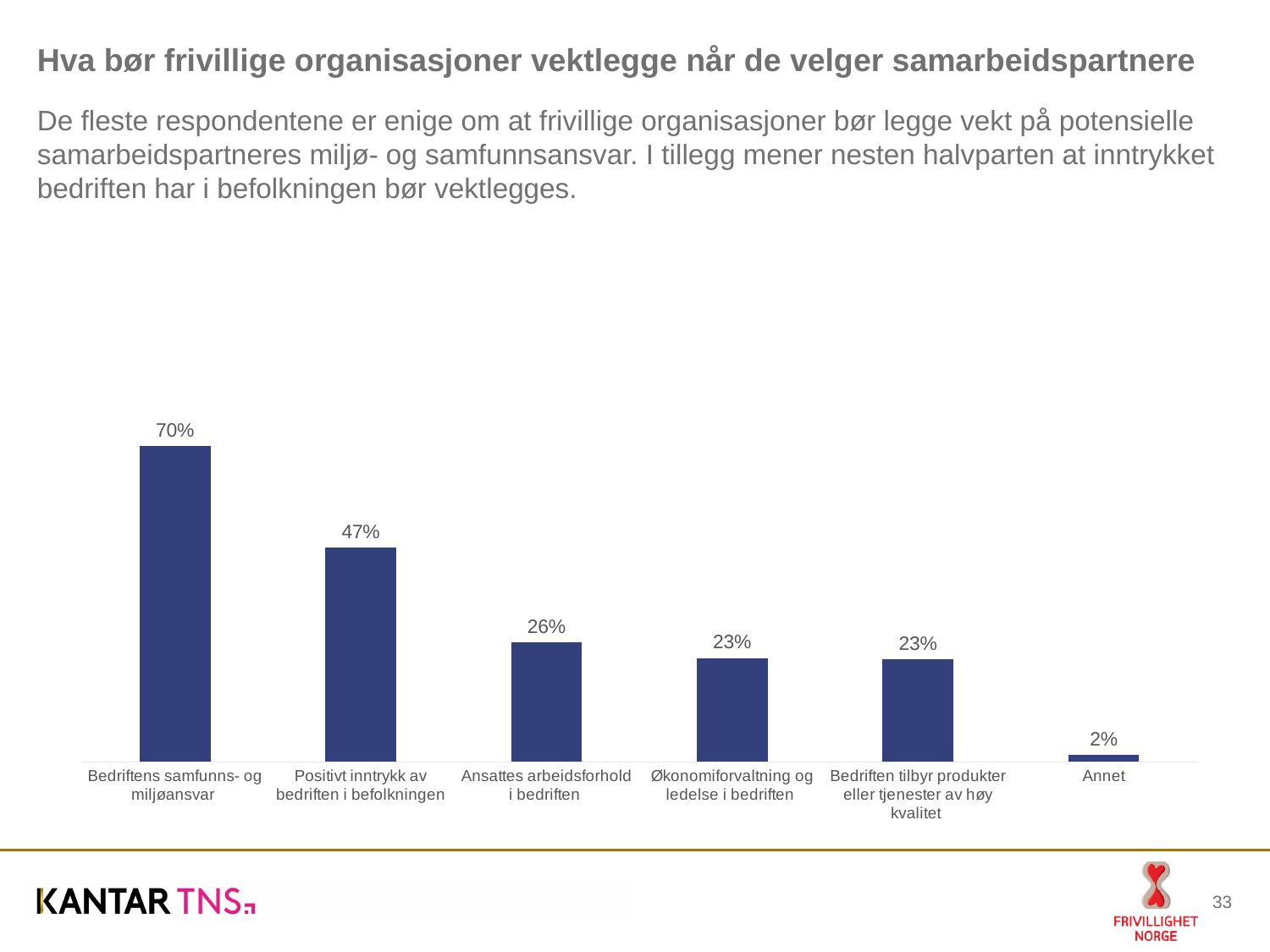
What is the value for "Positivt inntrykk av bedriften i befolkningen"? 47% Do the values generally rise or fall from left to right along the x axis? Fall How many categories are shown in the chart? 6 Which category has the lowest value? Annet What kind of chart is shown on the slide? Bar chart Which category has the highest value? Bedriftens samfunns- og miljøansvar What is the difference between the values for "Økonomiforvaltning og ledelse i bedriften" and "Bedriften tilbyr produkter eller tjenester av høy kvalitet"? 0% What is the value for "Ansattes arbeidsforhold i bedriften"? 26% Which is larger: the value for "Ansattes arbeidsforhold i bedriften" or the value for "Økonomiforvaltning og ledelse i bedriften"? Ansattes arbeidsforhold i bedriften What is the value for "Bedriftens samfunns- og miljøansvar"? 70% What is the difference between the values for "Bedriftens samfunns- og miljøansvar" and "Positivt inntrykk av bedriften i befolkningen"? 23% What is the value for "Annet"? 2%